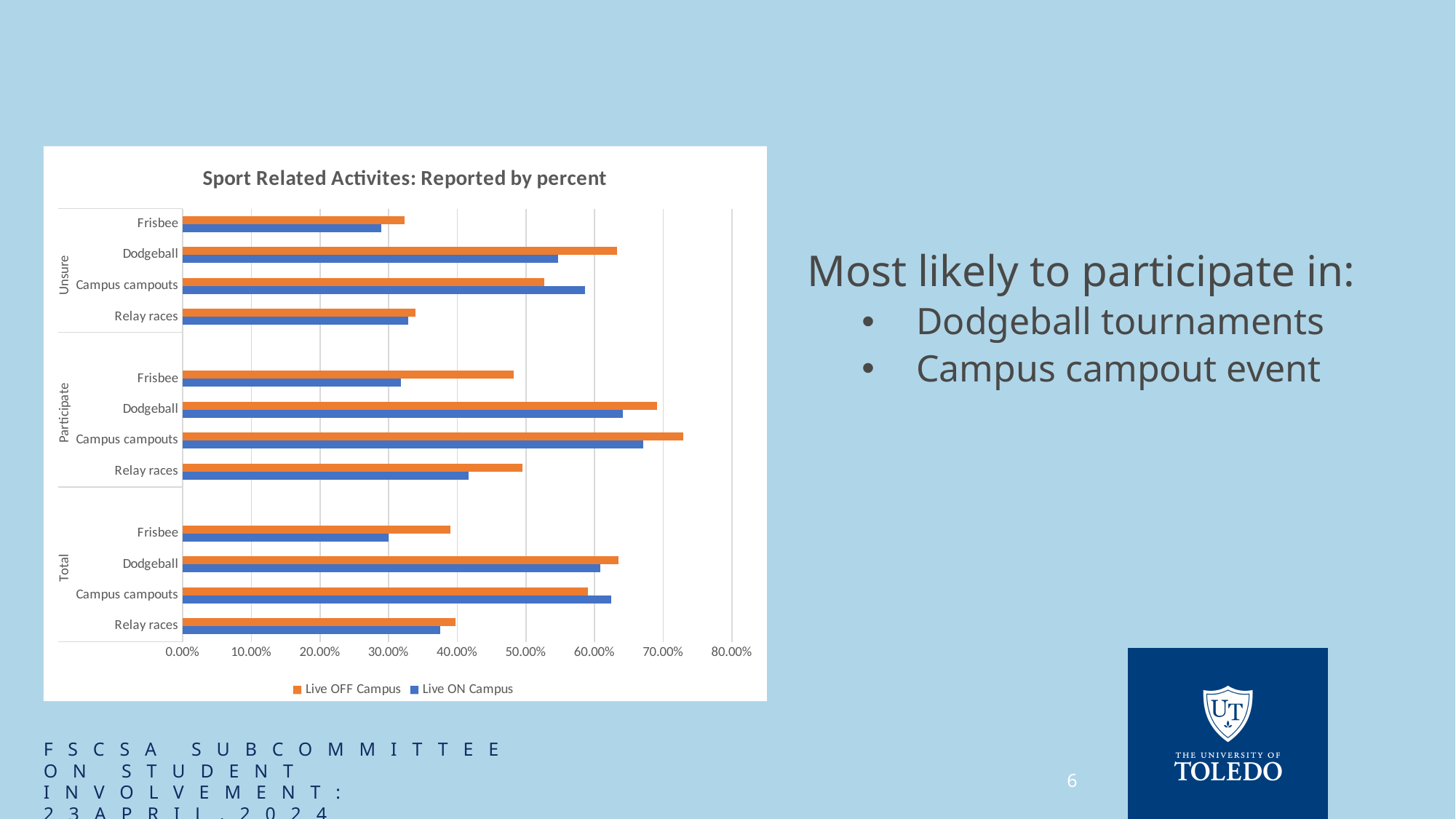
In the Participate group, which activity has the highest Live OFF Campus value? Campus campouts How many series does the chart legend list? 2 How many activity categories are listed under the Participate group? 4 What kind of chart is shown on the slide? Bar chart What is the title of the chart? Sport Related Activites: Reported by percent In the Participate group, which activity has the lowest Live ON Campus value? Frisbee Is the Live ON Campus value for Frisbee in the Participate group greater or less than 40.00%? less What are the two series named in the chart legend? Live OFF Campus and Live ON Campus In the Participate group, which is larger for Dodgeball: the Live OFF Campus value or the Live ON Campus value? Live OFF Campus In the Total group, which activity has the lowest Live ON Campus value? Frisbee Is the Live OFF Campus value for Campus campouts in the Participate group greater or less than 70.00%? greater In the Unsure group, which is larger for Campus campouts: the Live OFF Campus value or the Live ON Campus value? Live ON Campus